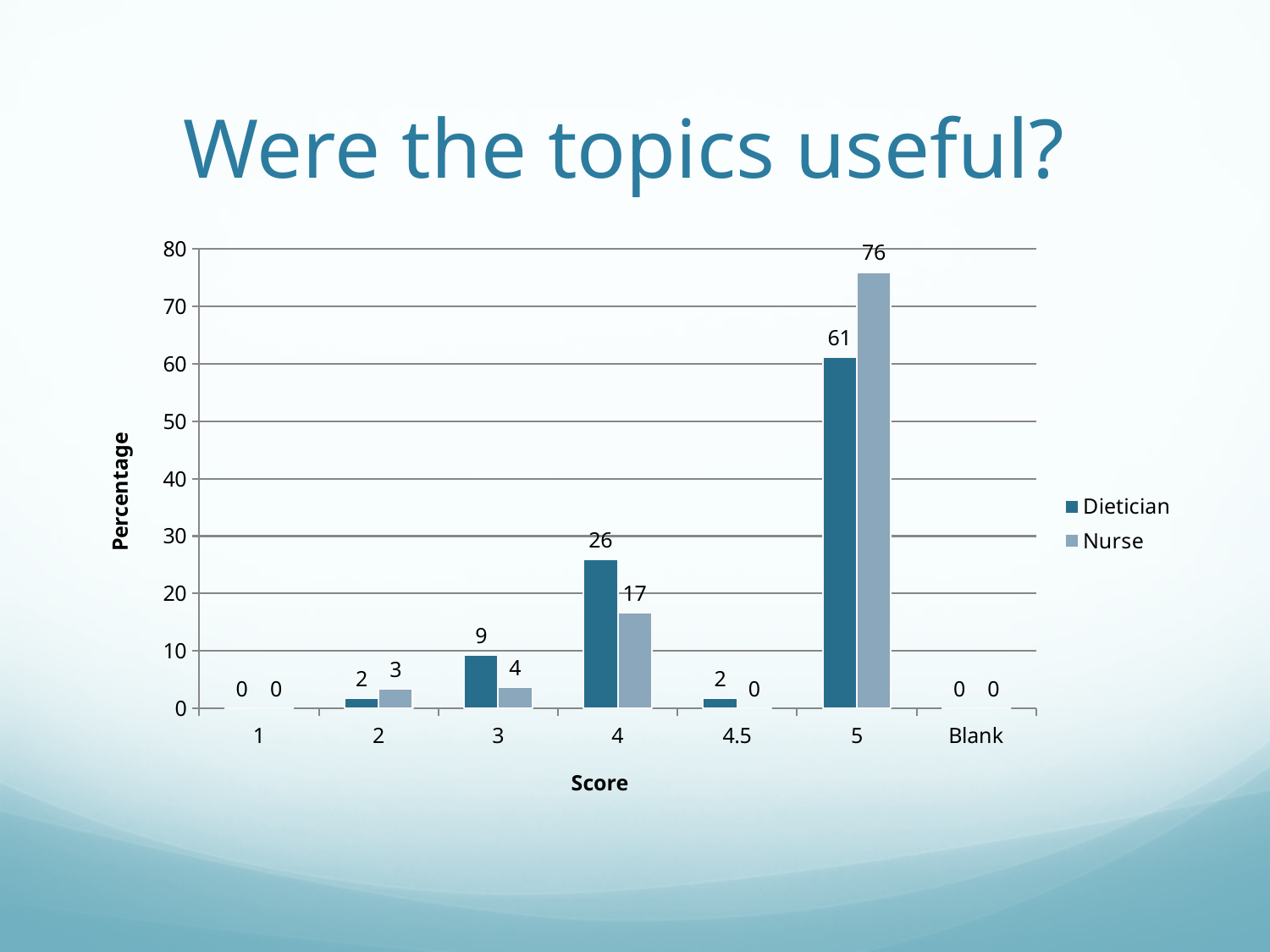
What is the Nurse value for score 4? 17 How many score categories are shown on the x axis? 7 Is the Nurse value for score 5 greater or less than 70? greater What is the Dietician value for score 3? 9 What is the Dietician value for score 5? 61 How many series does the legend list? 2 What kind of chart is shown on the slide? bar chart What is the difference between the Dietician and Nurse values for score 4? 9 Which is larger for score 3, the Dietician value or the Nurse value? Dietician What is the difference between the Nurse and Dietician values for score 5? 15 Which score has the highest Nurse value? 5 What is the label of the y axis? Percentage